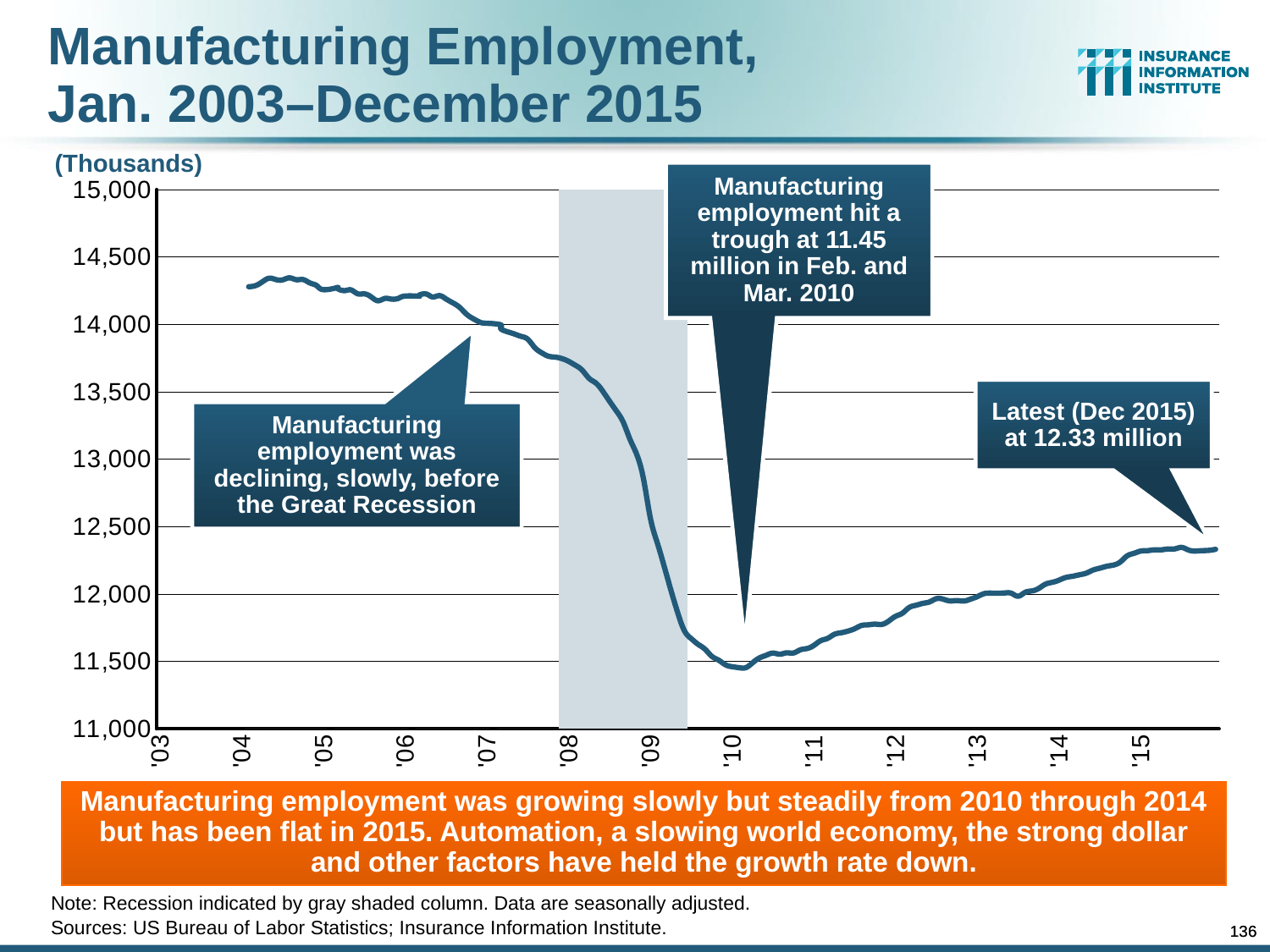
By how much does the Dec 2015 value (12.33 million) exceed the trough value (11.45 million)? 0.88 million Does manufacturing employment rise or fall between 2007 and early 2010? Fall According to the callout, what value did manufacturing employment hit at its trough? 11.45 million Does manufacturing employment rise or fall between 2010 and 2014? Rise What is the latest (Dec 2015) value of manufacturing employment shown on the chart? 12.33 million Is the value for manufacturing employment at the start of 2005 greater or less than 14,000? greater Is the value for manufacturing employment at the start of 2014 greater or less than 12,000? greater In which months did manufacturing employment hit its trough, according to the callout? Feb. and Mar. 2010 Is the value for manufacturing employment at the start of 2012 greater or less than 12,000? less What kind of chart is shown on the slide? Line chart What does the gray shaded column on the chart indicate? Recession Which is larger: the Dec 2015 value or the Feb./Mar. 2010 trough value? Dec 2015